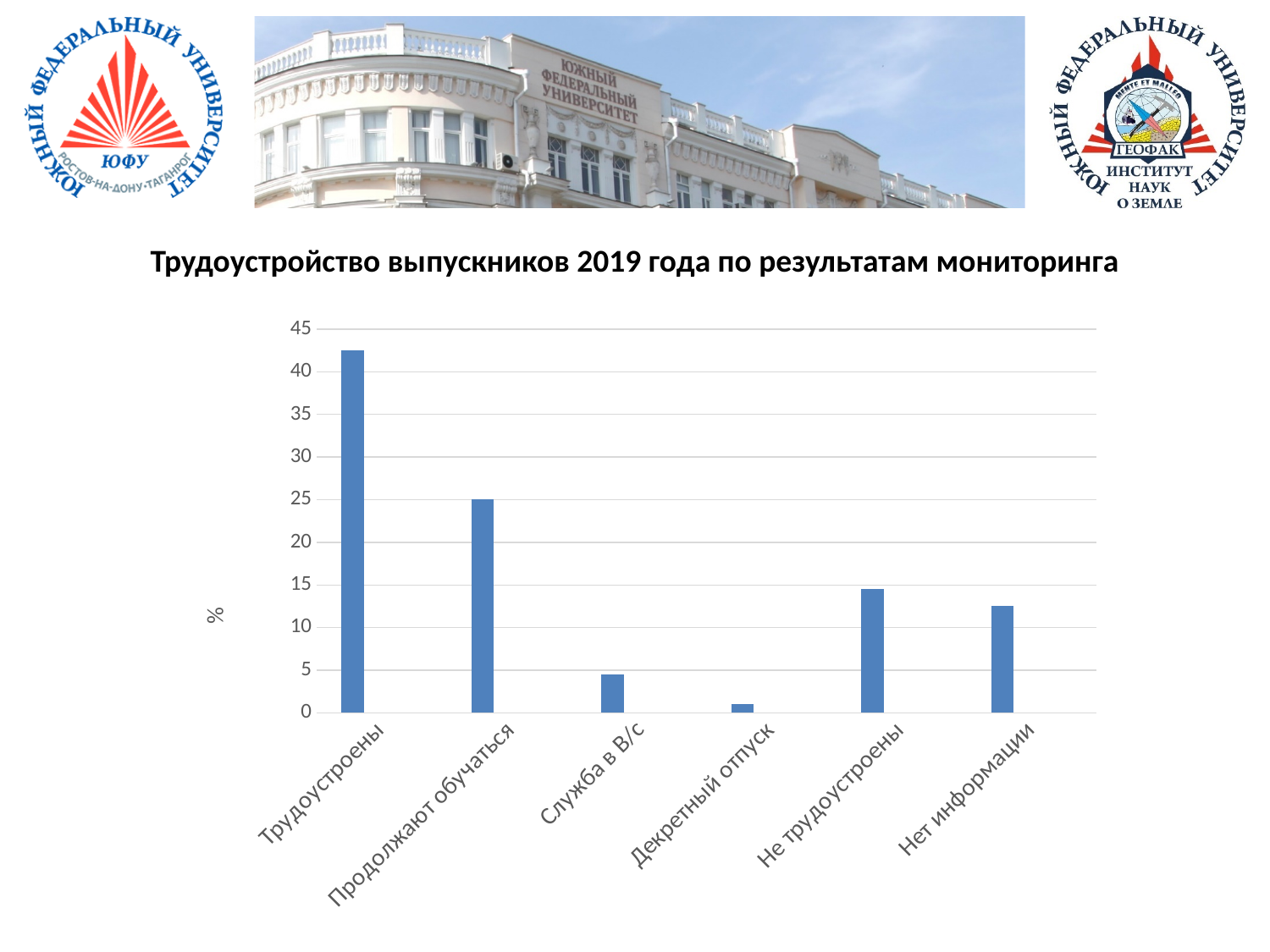
Which category has the lowest value in the chart? Декретный отпуск What is the label on the vertical axis of the chart? % Is the value for Не трудоустроены greater or less than 10? greater Which is larger, the value for Трудоустроены or the value for Продолжают обучаться? Трудоустроены What is the value for Продолжают обучаться? 25 Which is larger, the value for Служба в В/с or the value for Декретный отпуск? Служба в В/с Which category has the highest value in the chart? Трудоустроены Is the value for Трудоустроены greater or less than 40? greater How many categories are shown on the x axis of the chart? 6 Is the value for Нет информации greater or less than 15? less What kind of chart is shown on the slide? bar chart